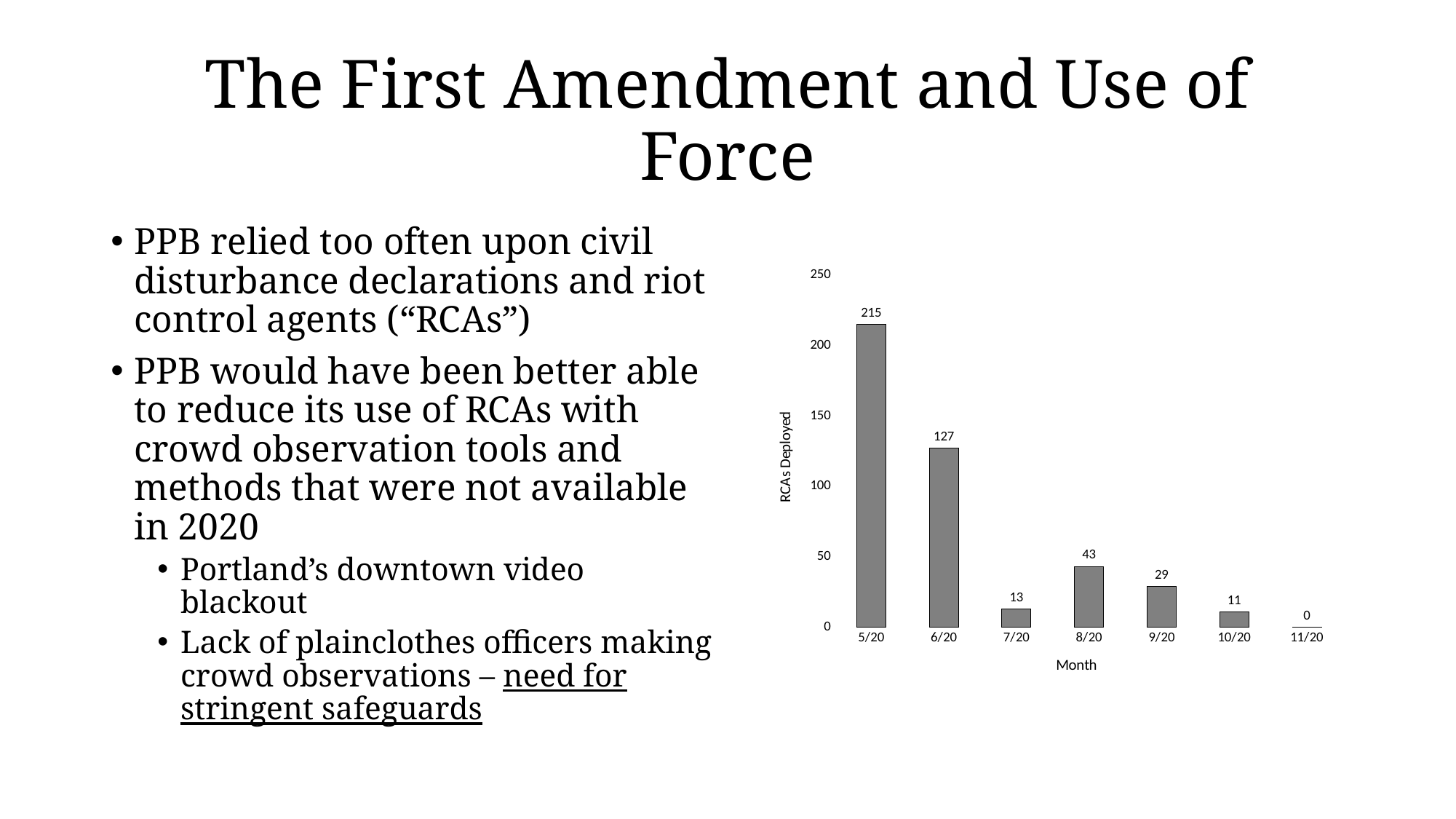
What kind of chart is shown on the slide? Bar chart How many months are shown on the x axis of the chart? 7 Which month had more RCAs deployed, 7/20 or 9/20? 9/20 How many RCAs were deployed in 5/20? 215 What is the difference in RCAs deployed between 5/20 and 6/20? 88 What is the label of the y axis of the chart? RCAs Deployed Which month had the lowest number of RCAs deployed? 11/20 How many RCAs were deployed in 11/20? 0 Which month had the highest number of RCAs deployed? 5/20 Is the value for 6/20 greater or less than 100? greater How many RCAs were deployed in 8/20? 43 What is the label of the x axis of the chart? Month